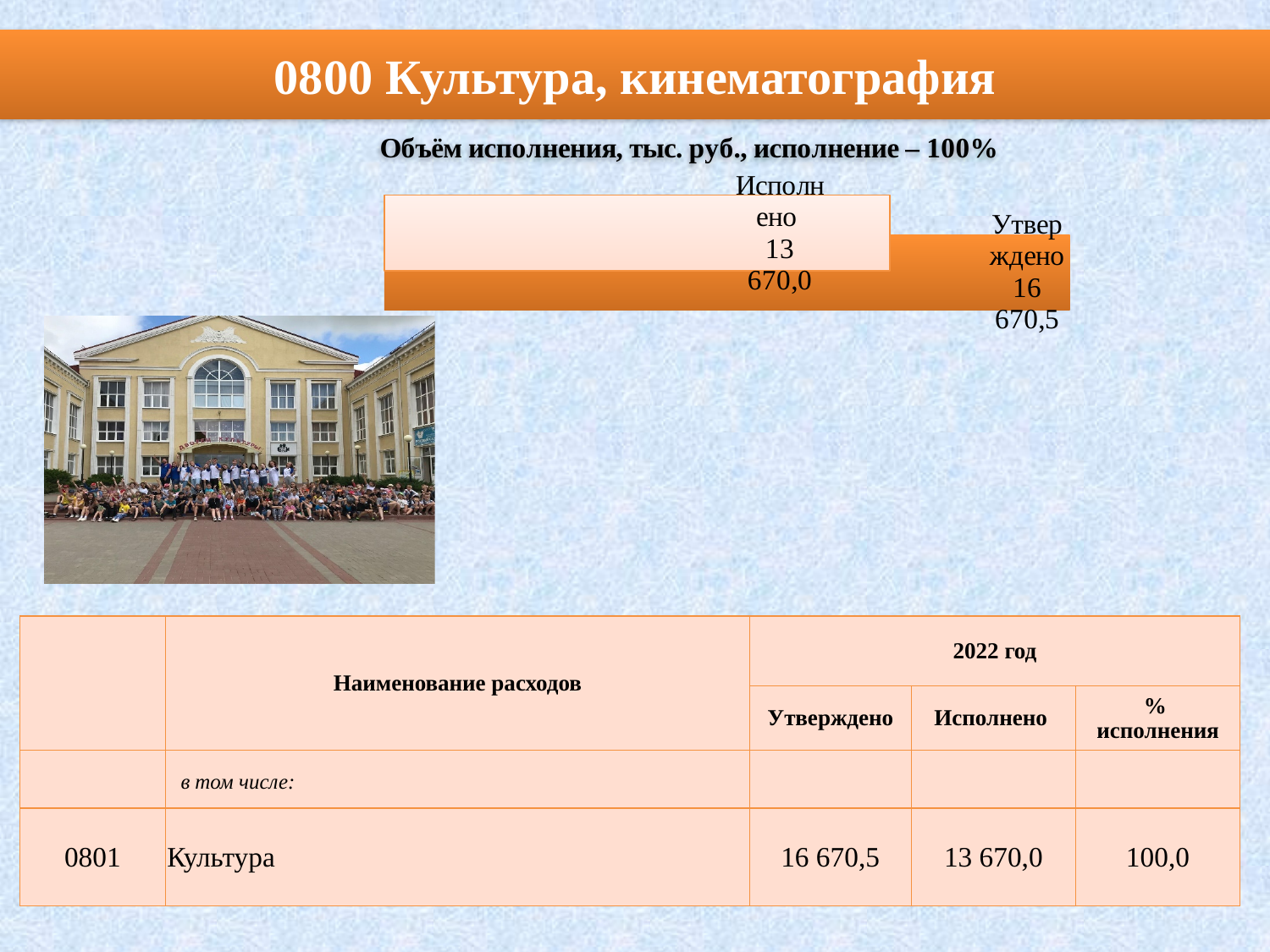
What is the value of the Утверждено bar? 16 670,5 How many bars are plotted in the chart? 2 What is the difference between the Утверждено value and the Исполнено value? 3 000,5 What is the value of the Исполнено bar? 13 670,0 Which bar has the higher value, Утверждено or Исполнено? Утверждено What is the title of the chart? Объём исполнения, тыс. руб., исполнение – 100% What kind of chart is shown on the slide? bar chart Is the Исполнено value larger or smaller than the Утверждено value? smaller What colour is the Утверждено bar? orange Which bar has the lowest value in the chart? Исполнено